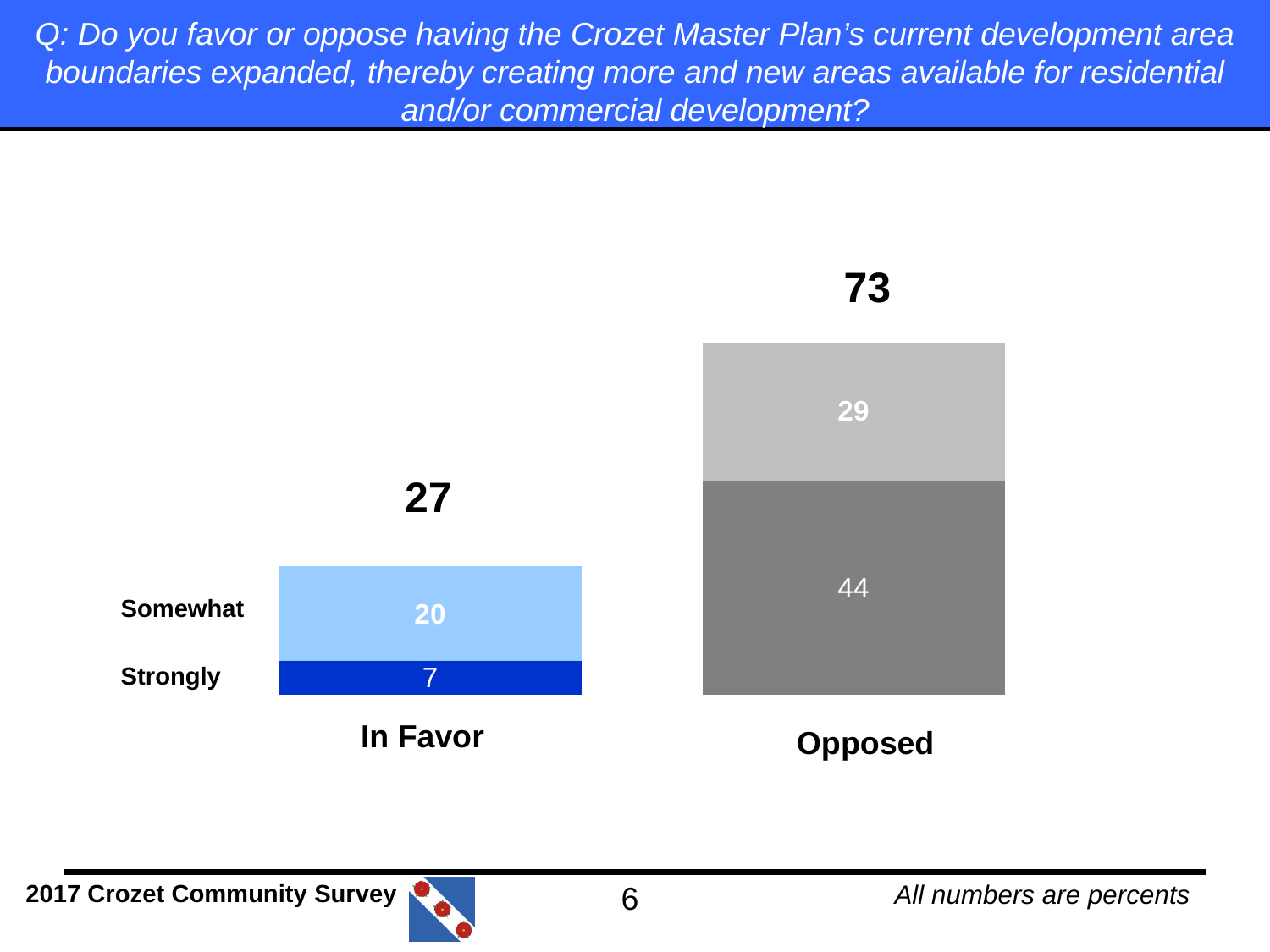
What is the total value shown above the In Favor bar? 27 How many categories are shown on the x axis of the chart? 2 What is the value of the Somewhat segment of the In Favor bar? 20 What is the total value shown above the Opposed bar? 73 What is the difference between the Opposed total and the In Favor total? 46 Which category has the higher total, In Favor or Opposed? Opposed What is the value of the Strongly segment of the In Favor bar? 7 What is the value of the bottom (dark gray) segment of the Opposed bar? 44 What is the value of the top (light gray) segment of the Opposed bar? 29 What is the sum of the two segments of the Opposed bar? 73 According to the note at the bottom of the slide, what unit are all numbers in? percents What kind of chart is shown on the slide? stacked bar chart